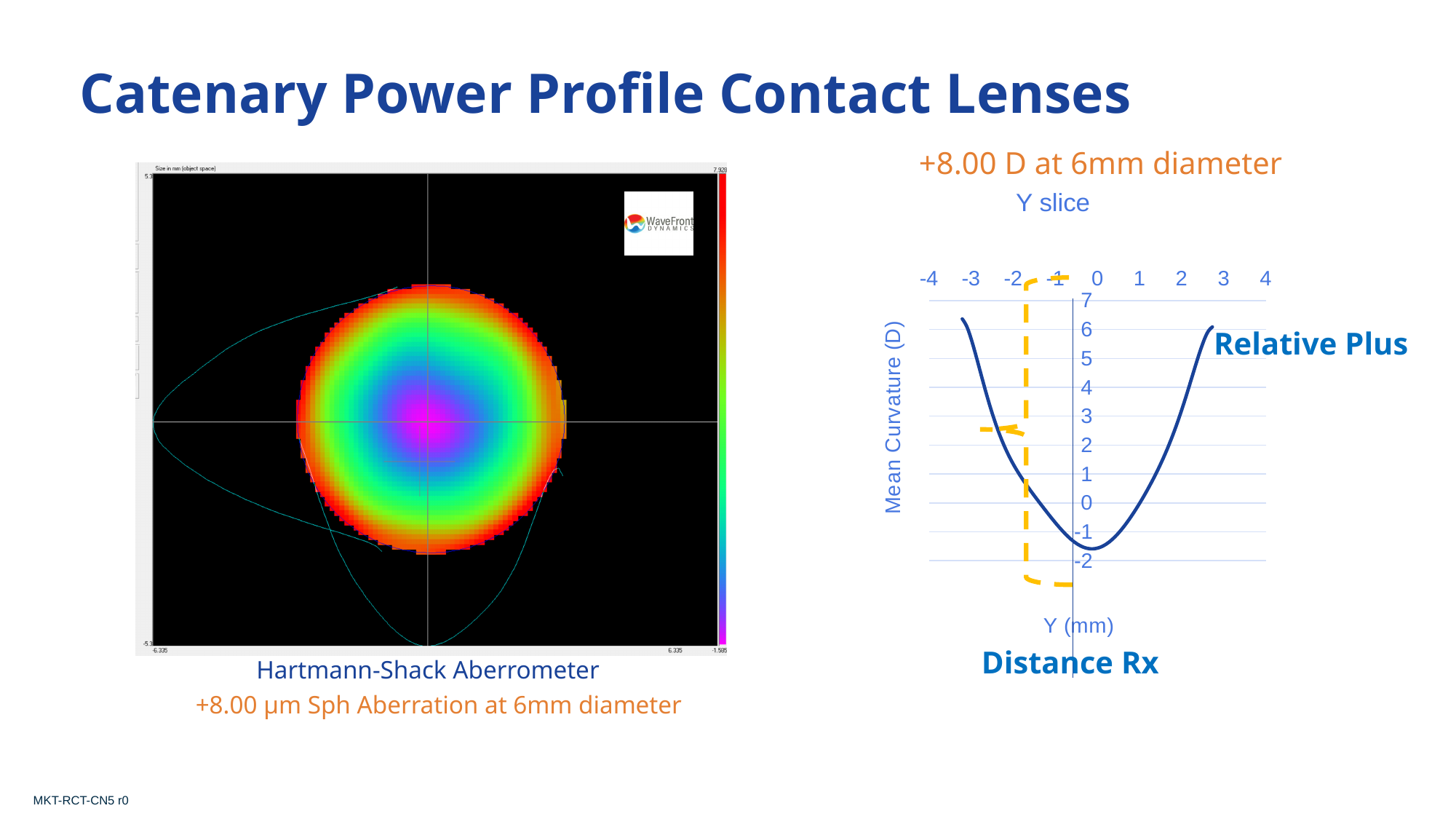
On the "Y slice" chart, is the value of the curve at Y = -2 greater or less than 3? less On the "Y slice" chart, is the value of the curve at Y = -3 greater or less than 5? greater On the "Y slice" chart, is the value of the curve at Y = 0 greater or less than 0? less On the "Y slice" chart, what is the label of the vertical axis? Mean Curvature (D) On the "Y slice" chart, which is larger: the curve value at Y = -3 or at Y = 2? Y = -3 On the "Y slice" chart, which is larger: the curve value at Y = -2 or at Y = 0? Y = -2 On the "Y slice" chart, does the curve rise or fall as Y goes from -3 to 0? fall On the "Y slice" chart, does the curve rise or fall as Y goes from 0 to 3? rise On the "Y slice" chart, what is the label of the horizontal axis? Y (mm) What kind of chart is the "Y slice" chart on the right of the slide? line chart How many tick labels are shown on the horizontal axis of the "Y slice" chart? 9